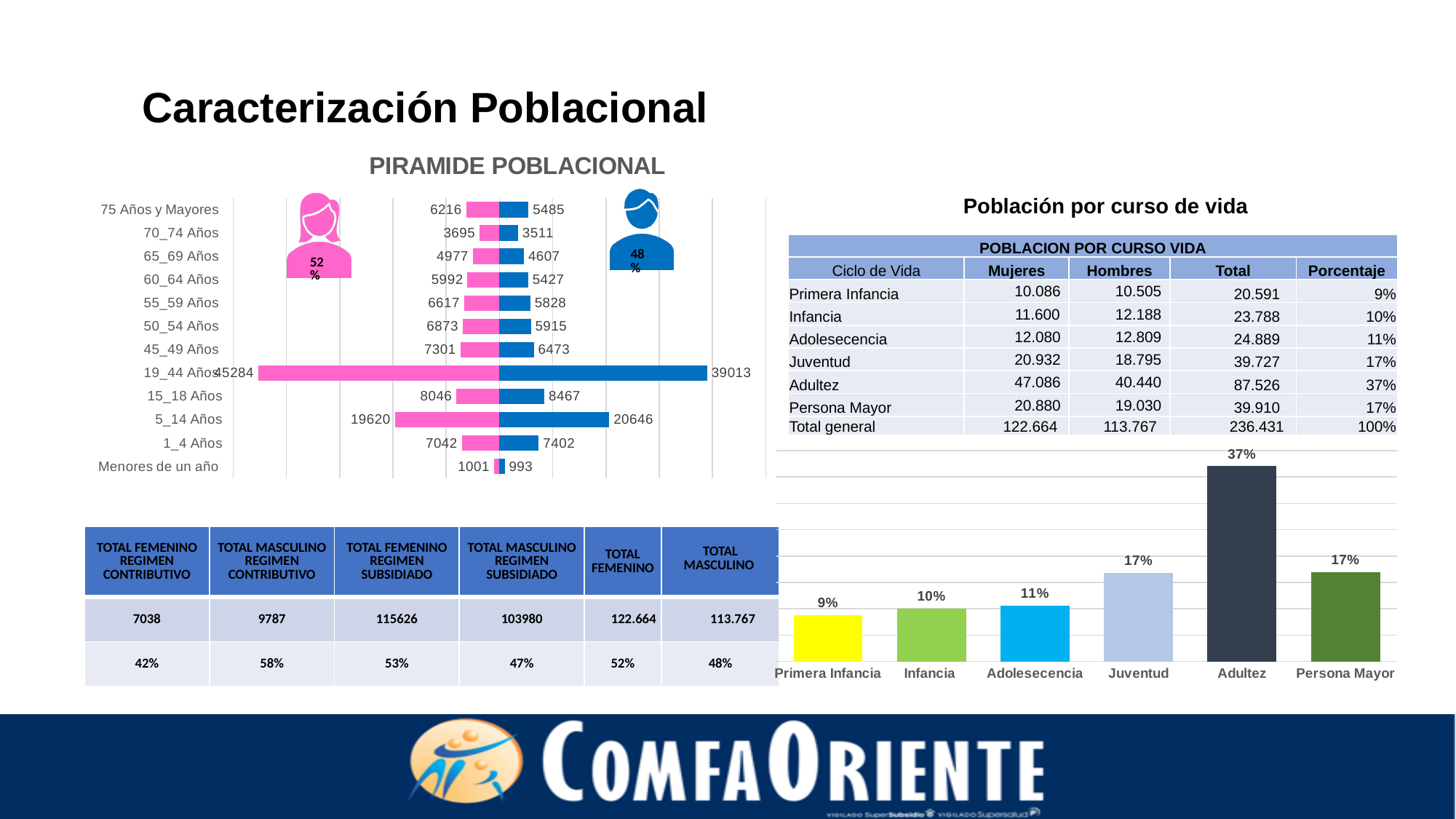
What type of chart is the PIRAMIDE POBLACIONAL chart? bar chart In the PIRAMIDE POBLACIONAL chart, for 15_18 Años, which is larger: the pink bar or the blue bar? the blue bar (8467) In the Población por curso de vida bar chart, what is the difference between Adultez and Juventud? 20% In the PIRAMIDE POBLACIONAL chart, what is the difference between the pink and blue bars for 19_44 Años? 6271 In the PIRAMIDE POBLACIONAL chart, which age group has the longest pink (female) bar? 19_44 Años In the PIRAMIDE POBLACIONAL chart, what is the value of the blue (male) bar for 5_14 Años? 20646 In the Población por curso de vida bar chart, what is the value for Adultez? 37% In the PIRAMIDE POBLACIONAL chart, what is the value of the blue (male) bar for Menores de un año? 993 In the PIRAMIDE POBLACIONAL chart, what is the value of the pink (female) bar for 19_44 Años? 45284 How many age groups are shown in the PIRAMIDE POBLACIONAL chart? 12 How many categories are shown in the Población por curso de vida bar chart? 6 In the Población por curso de vida bar chart, which category has the lowest value? Primera Infancia